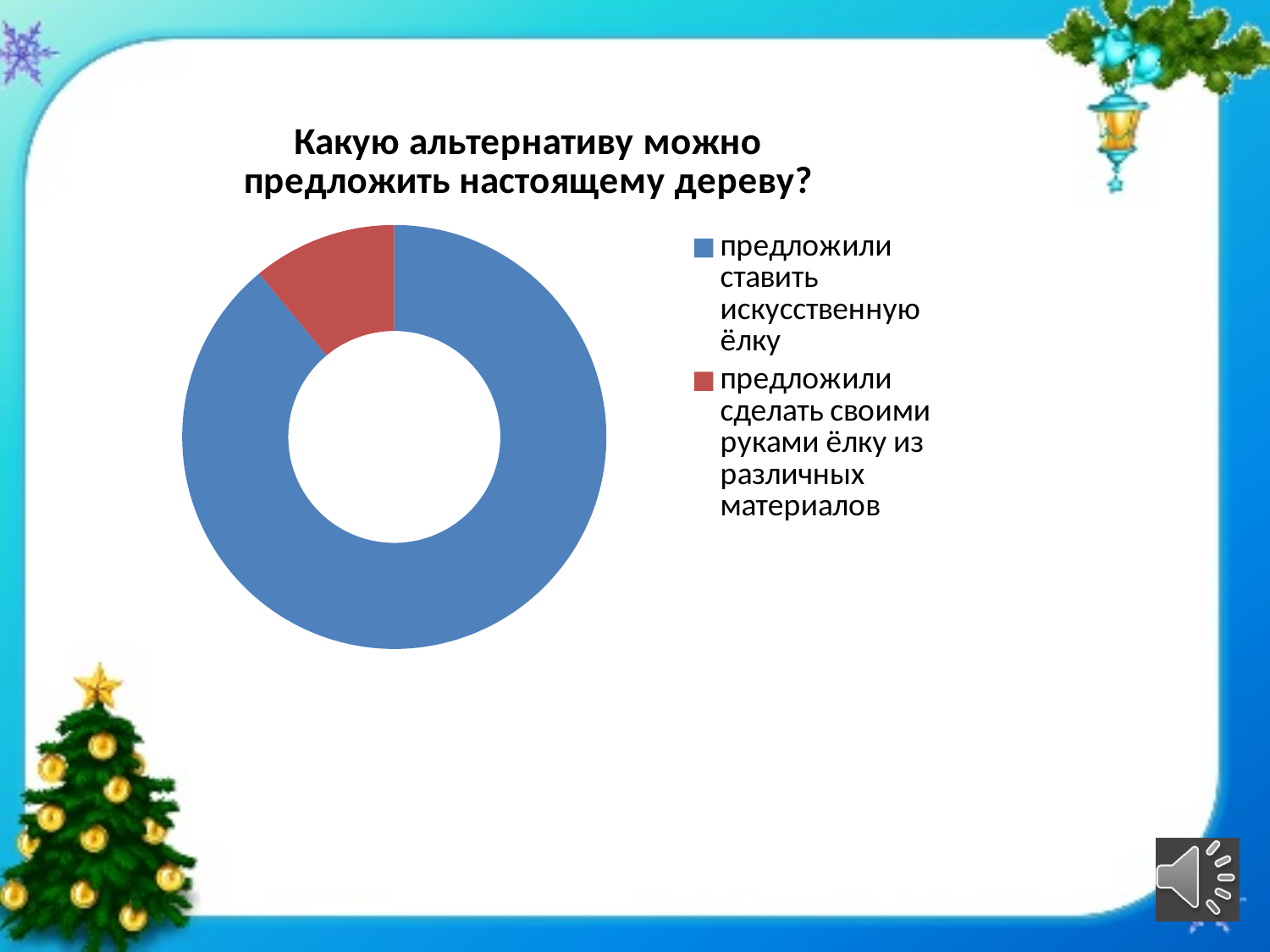
How many entries does the chart's legend list? 2 Which category has the smallest share of the chart? предложили сделать своими руками ёлку из различных материалов How many categories does the chart show? 2 What colour represents "предложили сделать своими руками ёлку из различных материалов" in the chart? red What is the title of the chart? Какую альтернативу можно предложить настоящему дереву? Which category has the largest share of the chart? предложили ставить искусственную ёлку What kind of chart is shown on the slide? doughnut chart Which is larger: the share for "предложили ставить искусственную ёлку" or the share for "предложили сделать своими руками ёлку из различных материалов"? предложили ставить искусственную ёлку